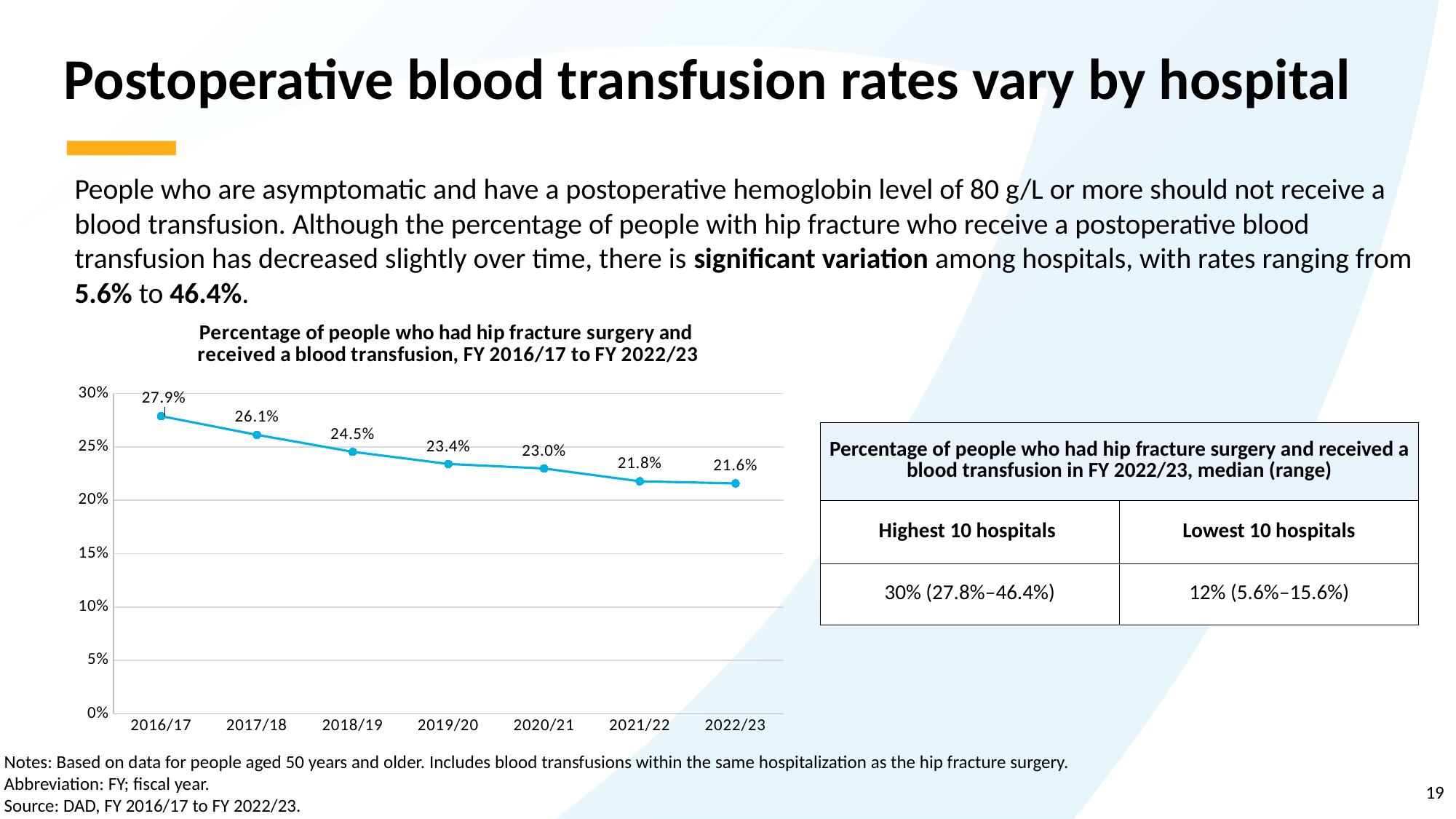
Is the value for FY 2021/22 greater or less than 25%? less What is the difference between the values for FY 2016/17 and FY 2022/23? 6.3% Which fiscal year has the highest percentage of people receiving a blood transfusion? 2016/17 What percentage of people who had hip fracture surgery received a blood transfusion in FY 2016/17? 27.9% What is the value for FY 2019/20 in the line chart? 23.4% Which fiscal year has the lowest percentage of people receiving a blood transfusion? 2022/23 Do the values rise or fall from FY 2016/17 to FY 2022/23? fall What kind of chart is used to show the percentage of people who received a blood transfusion over time? line chart Which is larger, the value for FY 2018/19 or the value for FY 2020/21? 2018/19 What is the value for FY 2022/23 in the line chart? 21.6% What is the difference between the values for FY 2017/18 and FY 2018/19? 1.6% How many fiscal years are plotted on the line chart? 7